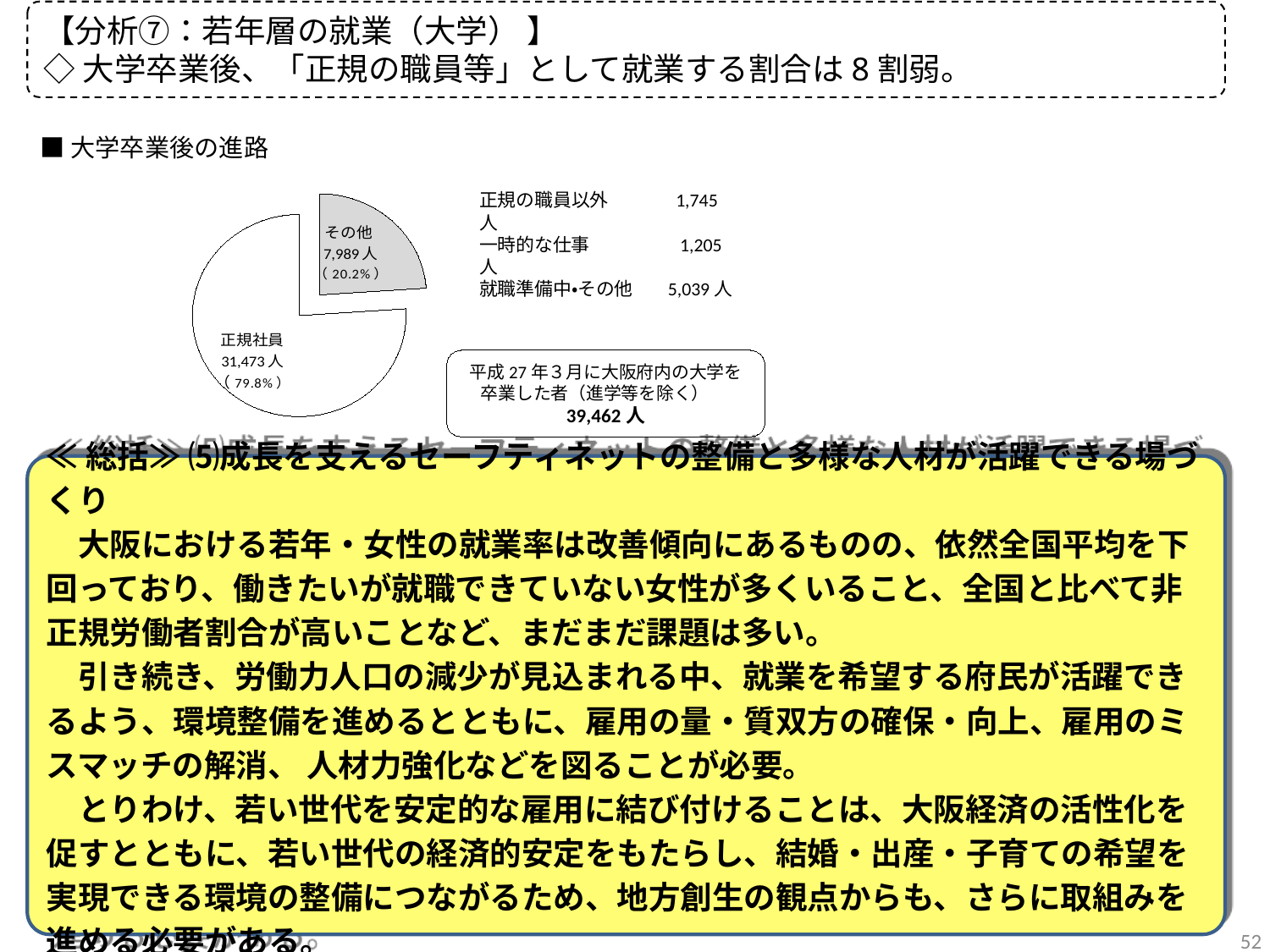
How many people are in the 正規社員 slice of the pie chart? 31,473人 What share of the pie does the その他 slice represent? 20.2% Which is larger, the 正規社員 slice or the その他 slice? 正規社員 Which slice of the pie chart is the largest? 正規社員 Which slice of the pie chart is shaded grey? その他 How many people are in the その他 slice of the pie chart? 7,989人 What is the difference in number of people between the 正規社員 slice and the その他 slice? 23,484人 What share of the pie does the 正規社員 slice represent? 79.8% What is the total number of people represented by the pie chart? 39,462人 Which slice of the pie chart is the smallest? その他 What kind of chart is shown under 「大学卒業後の進路」? pie chart How many slices does the pie chart have? 2